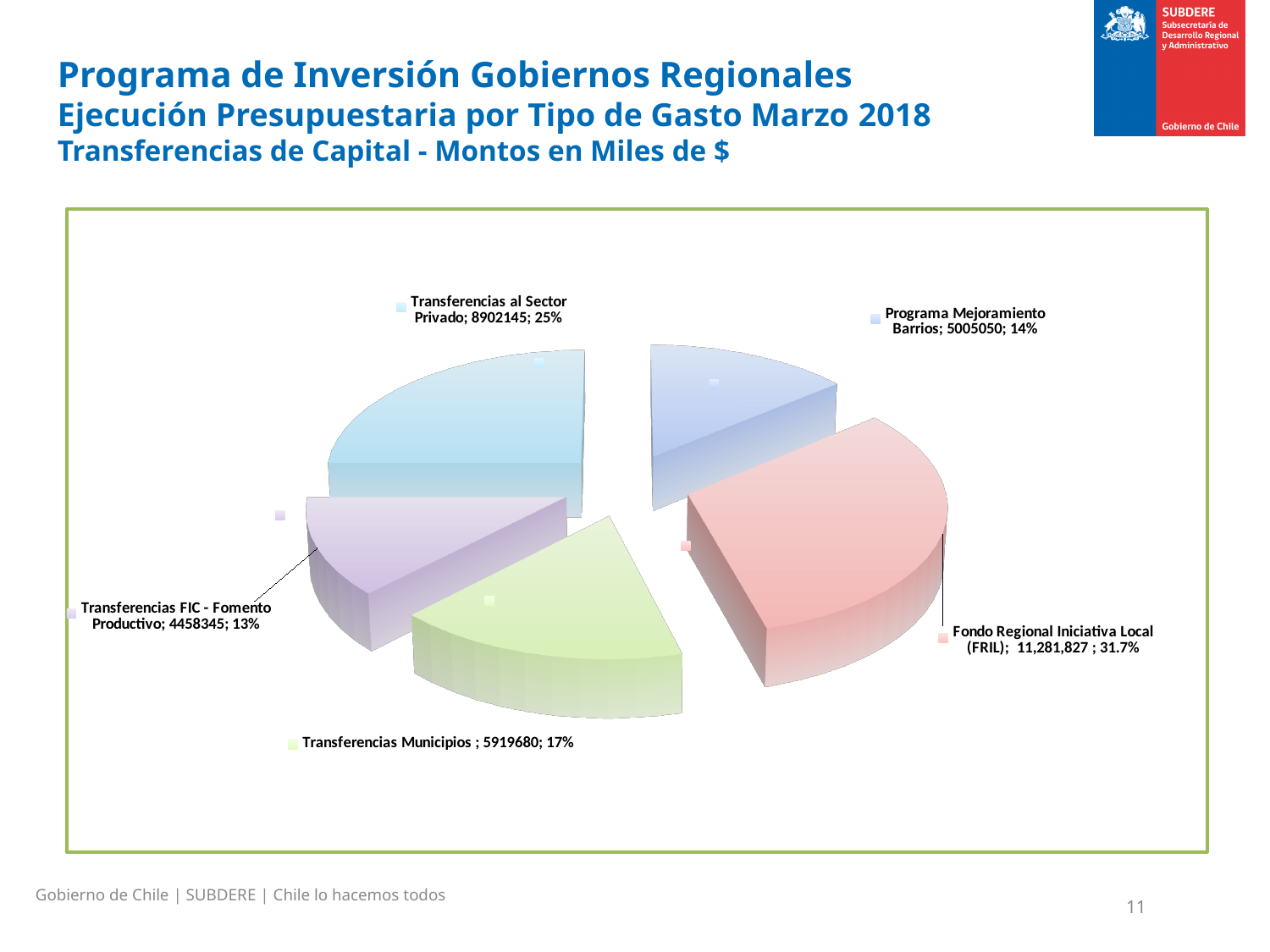
What percentage share does Fondo Regional Iniciativa Local (FRIL) have? 31.7% What percentage share does Transferencias al Sector Privado have? 25% What is the value shown for Programa Mejoramiento Barrios? 5005050 What kind of chart is shown on the slide? Pie chart What is the value shown for Transferencias FIC - Fomento Productivo? 4458345 Which is larger, the value for Transferencias Municipios or the value for Programa Mejoramiento Barrios? Transferencias Municipios Which category has the smallest slice of the pie? Transferencias FIC - Fomento Productivo What is the value shown for Transferencias al Sector Privado? 8902145 What is the difference between the values for Transferencias al Sector Privado and Transferencias Municipios? 2982465 How many slices does the pie chart have? 5 Which category has the largest slice of the pie? Fondo Regional Iniciativa Local (FRIL) What percentage share does Transferencias Municipios have? 17%